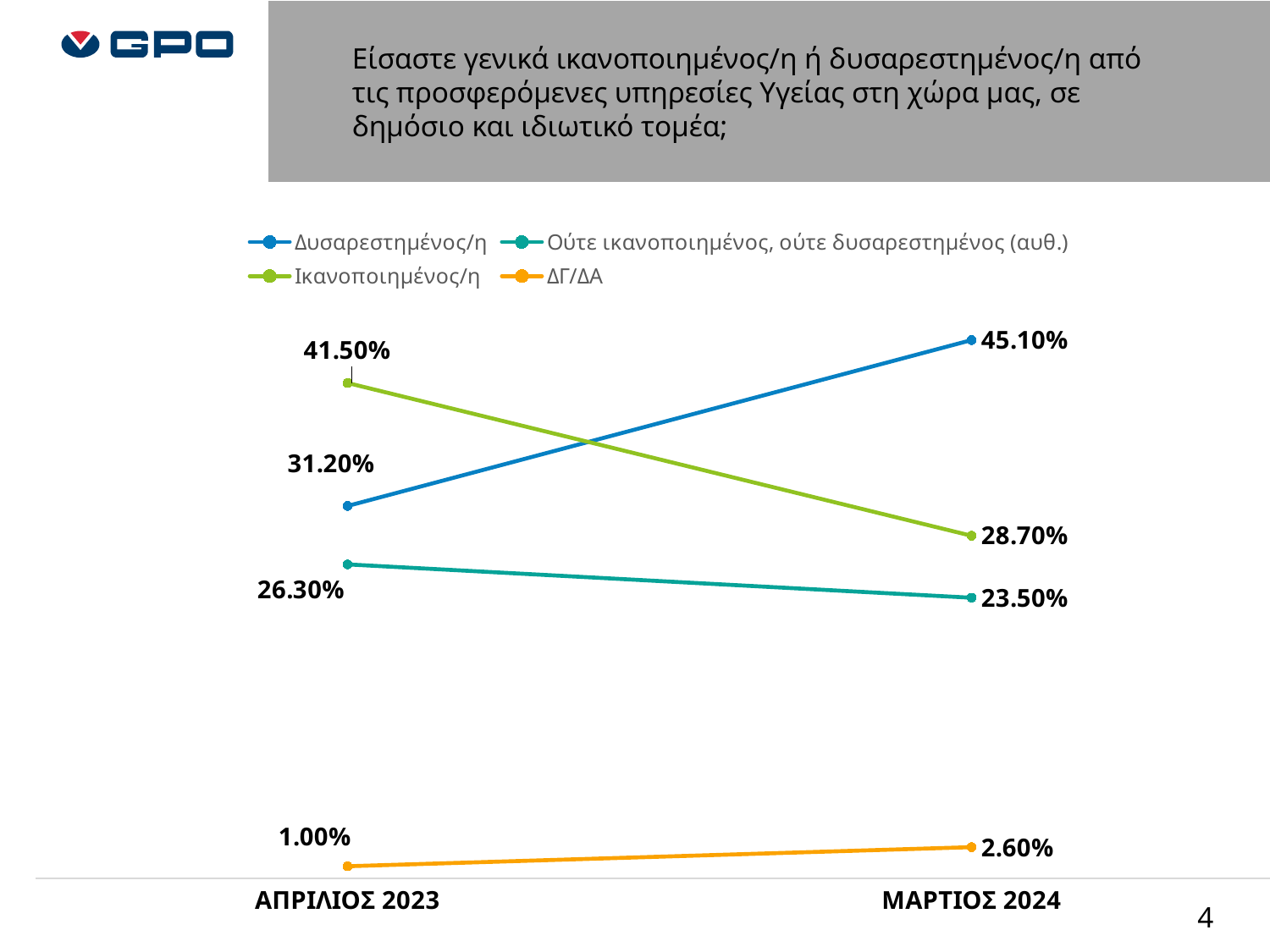
What is the value for Δυσαρεστημένος/η in ΜΑΡΤΙΟΣ 2024? 45.10% By how much did the value for Δυσαρεστημένος/η change from ΑΠΡΙΛΙΟΣ 2023 to ΜΑΡΤΙΟΣ 2024? 13.90% Does the value for Ικανοποιημένος/η rise or fall from ΑΠΡΙΛΙΟΣ 2023 to ΜΑΡΤΙΟΣ 2024? fall Which series has the lowest value in ΑΠΡΙΛΙΟΣ 2023? ΔΓ/ΔΑ How many time points are shown on the x axis? 2 What is the value for Ούτε ικανοποιημένος, ούτε δυσαρεστημένος (αυθ.) in ΑΠΡΙΛΙΟΣ 2023? 26.30% What is the value for Ικανοποιημένος/η in ΑΠΡΙΛΙΟΣ 2023? 41.50% Which series has the highest value in ΜΑΡΤΙΟΣ 2024? Δυσαρεστημένος/η Which is larger in ΑΠΡΙΛΙΟΣ 2023: Δυσαρεστημένος/η or Ικανοποιημένος/η? Ικανοποιημένος/η How many series does the legend list? 4 What type of chart is shown on the slide? line chart What is the value for ΔΓ/ΔΑ in ΜΑΡΤΙΟΣ 2024? 2.60%